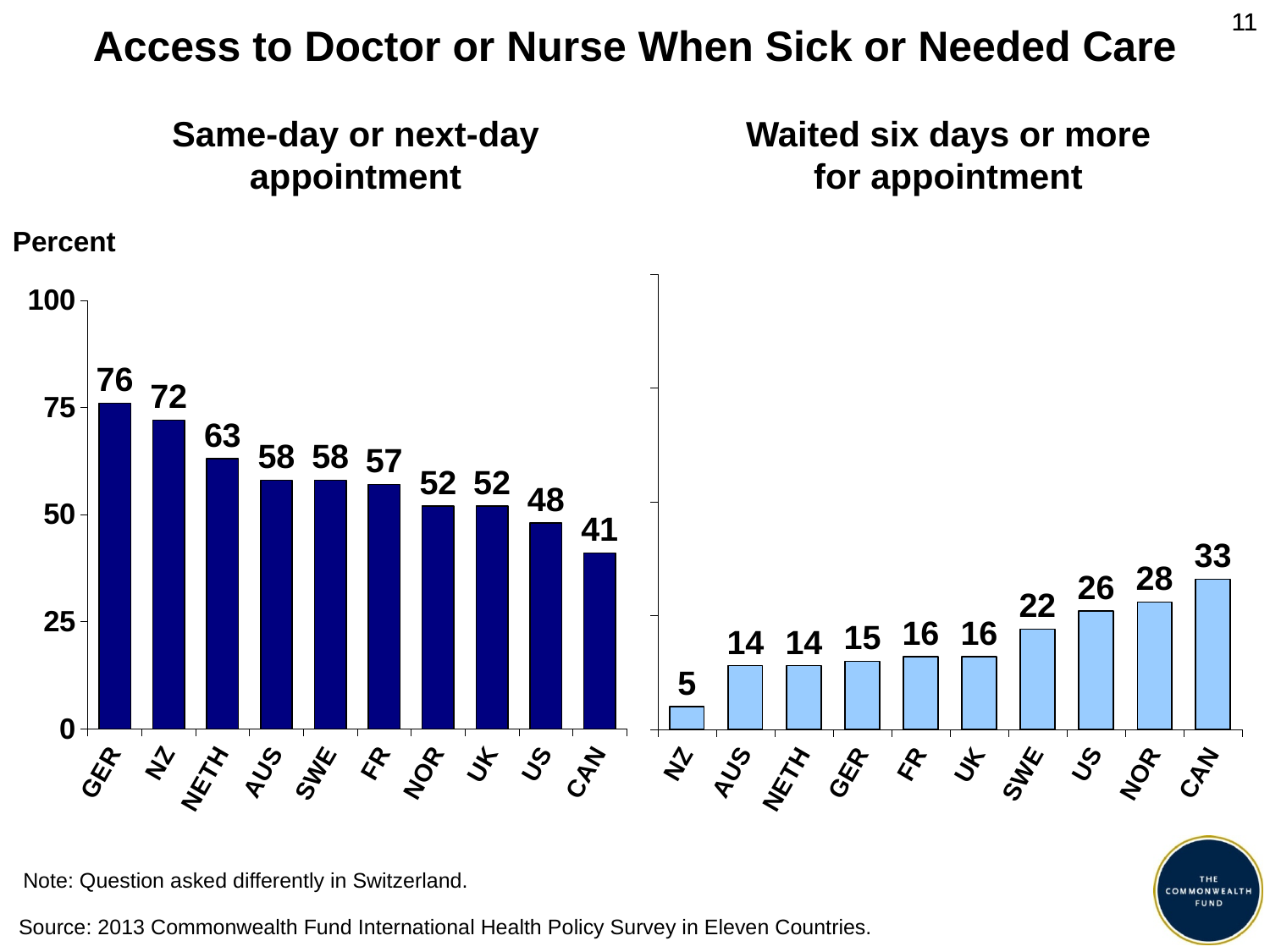
In the 'Same-day or next-day appointment' chart, what is the value for GER? 76 In the 'Waited six days or more for appointment' chart, do the values rise or fall from left to right? rise In the 'Same-day or next-day appointment' chart, is the value for US greater or less than 50? less In the 'Same-day or next-day appointment' chart, which is larger, the value for NZ or the value for NETH? NZ How many countries are shown in the 'Waited six days or more for appointment' chart? 10 What kind of chart is the 'Same-day or next-day appointment' chart? bar chart In the 'Waited six days or more for appointment' chart, what is the difference between US and NZ? 21 In the 'Same-day or next-day appointment' chart, which country has the lowest value? CAN In the 'Waited six days or more for appointment' chart, what is the value for CAN? 33 In the 'Waited six days or more for appointment' chart, which country has the highest value? CAN In the 'Same-day or next-day appointment' chart, what is the difference between GER and CAN? 35 In the 'Waited six days or more for appointment' chart, which country has the lowest value? NZ